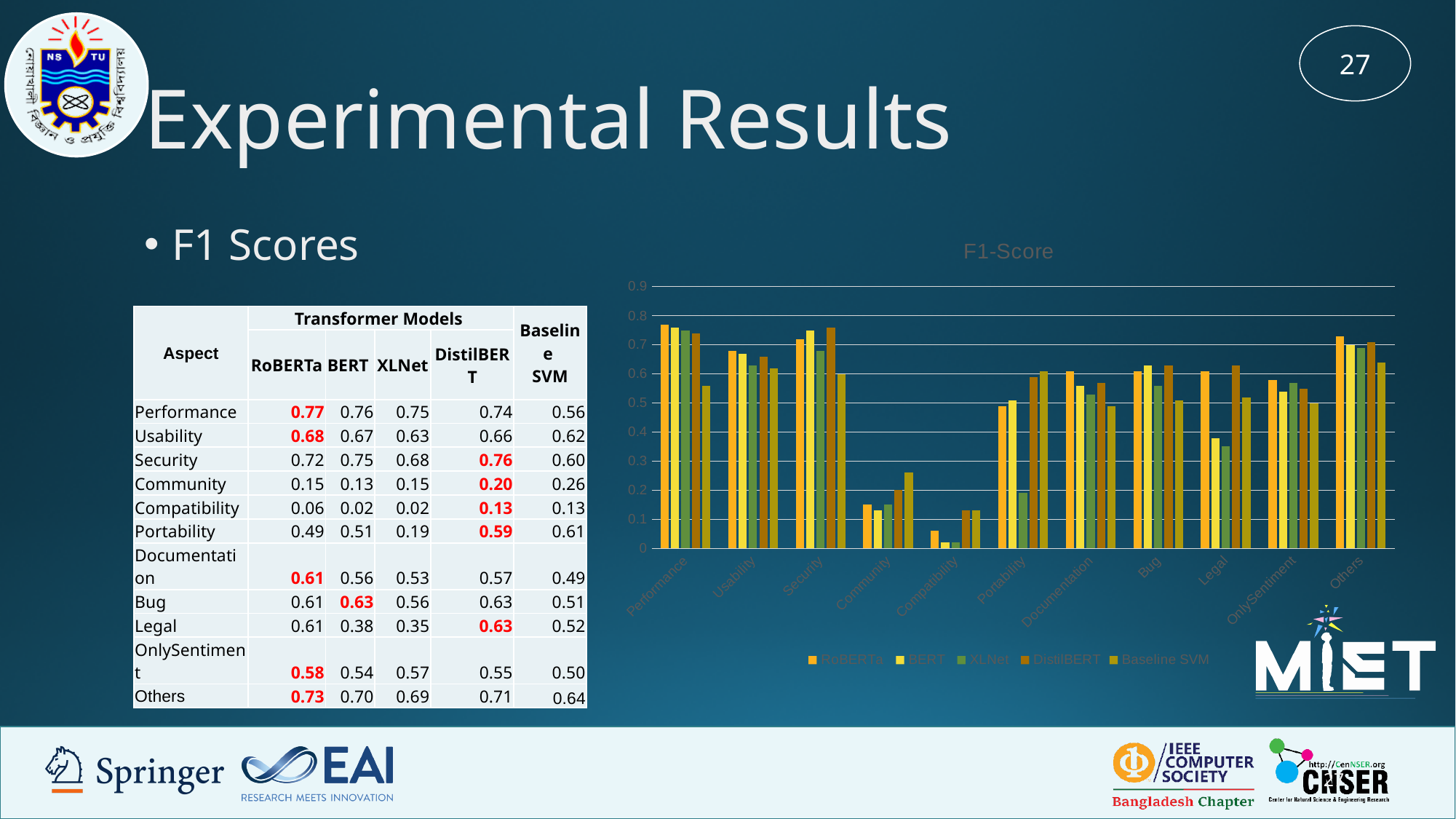
What kind of chart is the F1-Score chart? bar chart Which series are listed in the legend of the F1-Score chart? RoBERTa, BERT, XLNet, DistilBERT, Baseline SVM In the F1-Score chart, which aspect has the highest RoBERTa value? Performance In the F1-Score chart, is the RoBERTa value for Performance greater or less than 0.7? greater In the F1-Score chart, for Portability, which is larger: RoBERTa or Baseline SVM? Baseline SVM What is the title of the chart on the slide? F1-Score What is the DistilBERT F1 score for Security? 0.76 How many series does the legend of the F1-Score chart list? 5 In the F1-Score chart, is the Baseline SVM value for Community greater or less than 0.3? less What is the difference between the RoBERTa and BERT F1 scores for Legal? 0.23 In the F1-Score chart, which aspect has the lowest BERT value? Compatibility How many aspect categories are shown on the x axis of the F1-Score chart? 11